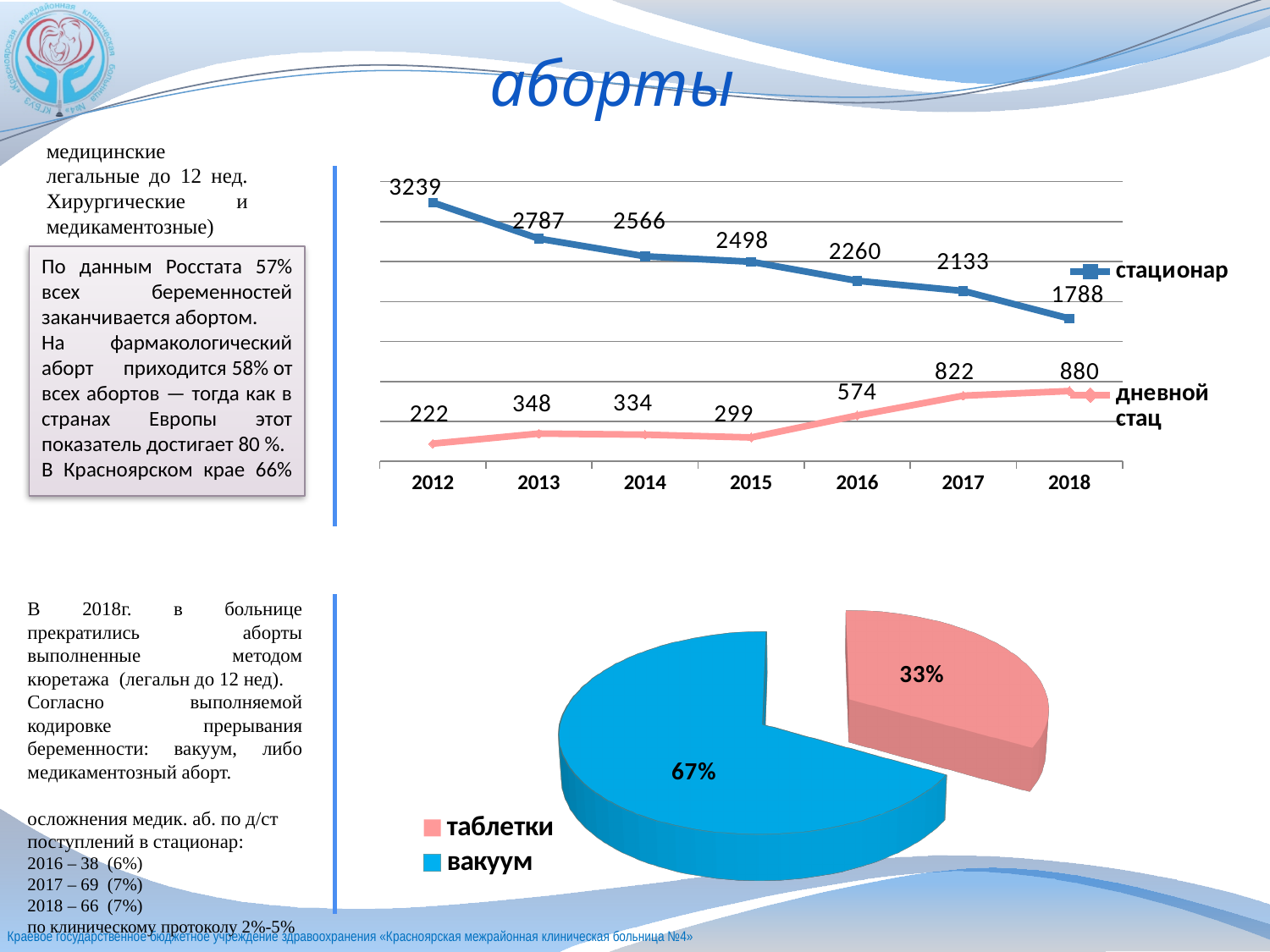
In the line chart at the top, does the стационар series rise or fall from 2012 to 2018? fall In the line chart at the top, which is larger in 2016: стационар or дневной стац? стационар In the line chart at the top, how many years are shown on the x axis? 7 In the line chart at the top, what is the value for стационар in 2018? 1788 In the line chart at the top, in which year is the стационар value lowest? 2018 In the pie chart at the bottom, what share does вакуум have? 67% What kind of chart is shown at the bottom of the slide? pie chart In the line chart at the top, in which year is the дневной стац value highest? 2018 In the line chart at the top, what is the value for дневной стац in 2017? 822 In the line chart at the top, what is the difference between the стационар values in 2012 and 2018? 1451 In the line chart at the top, what is the value for стационар in 2012? 3239 In the line chart at the top, how many series does the legend list? 2